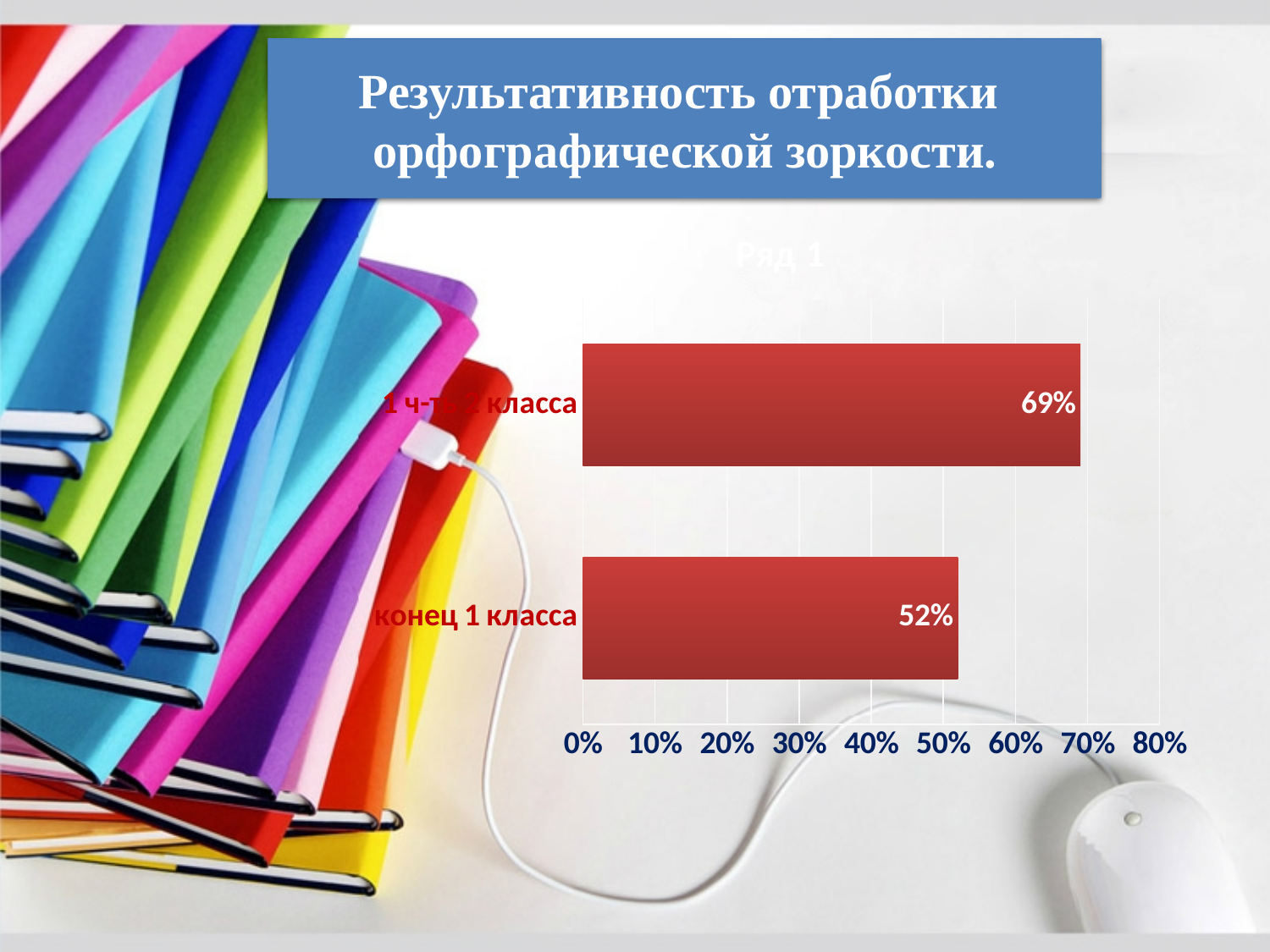
Which is larger: the value for "конец 1 класса" or the value of the top bar? the top bar Is the value for "конец 1 класса" greater or less than 60%? less What type of chart is shown on the slide? bar chart How many bars are plotted in the chart? 2 What is the highest value shown on the horizontal axis? 80% Is the value of the top bar greater or less than 60%? greater What is the value for "конец 1 класса"? 52% What is the difference between the top bar's value and the value for "конец 1 класса"? 17% What colour are the bars in the chart? red Which category has the lowest value? конец 1 класса What is the value shown on the top bar (the one for 2 класса)? 69% Which category has the highest value? the top bar (2 класса)